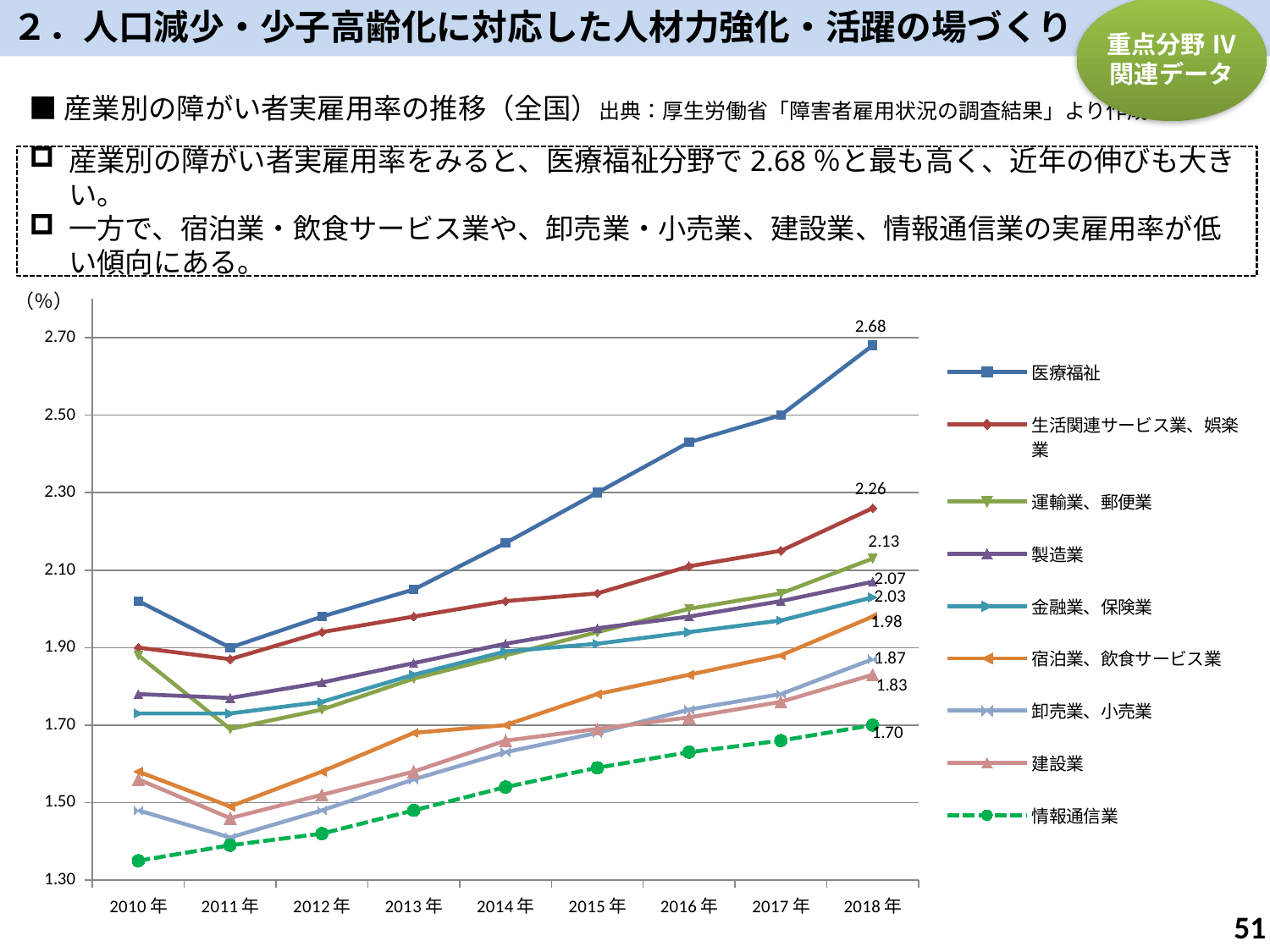
Is the value for 医療福祉 in 2010年 greater or less than 1.90? greater What type of chart is shown on the slide? line chart How many years are shown on the x axis? 9 What is the value for 製造業 in 2018年? 2.07 Which series has the highest value in 2018年? 医療福祉 What is the value for 医療福祉 in 2018年? 2.68 How many series does the legend list? 9 Which series has the lowest value in 2018年? 情報通信業 What is the difference between the 2018年 values for 医療福祉 and 情報通信業? 0.98 In 2018年, which is larger: 運輸業、郵便業 or 金融業、保険業? 運輸業、郵便業 Does the value for 情報通信業 rise or fall from 2010年 to 2018年? rise What is the value for 情報通信業 in 2018年? 1.70